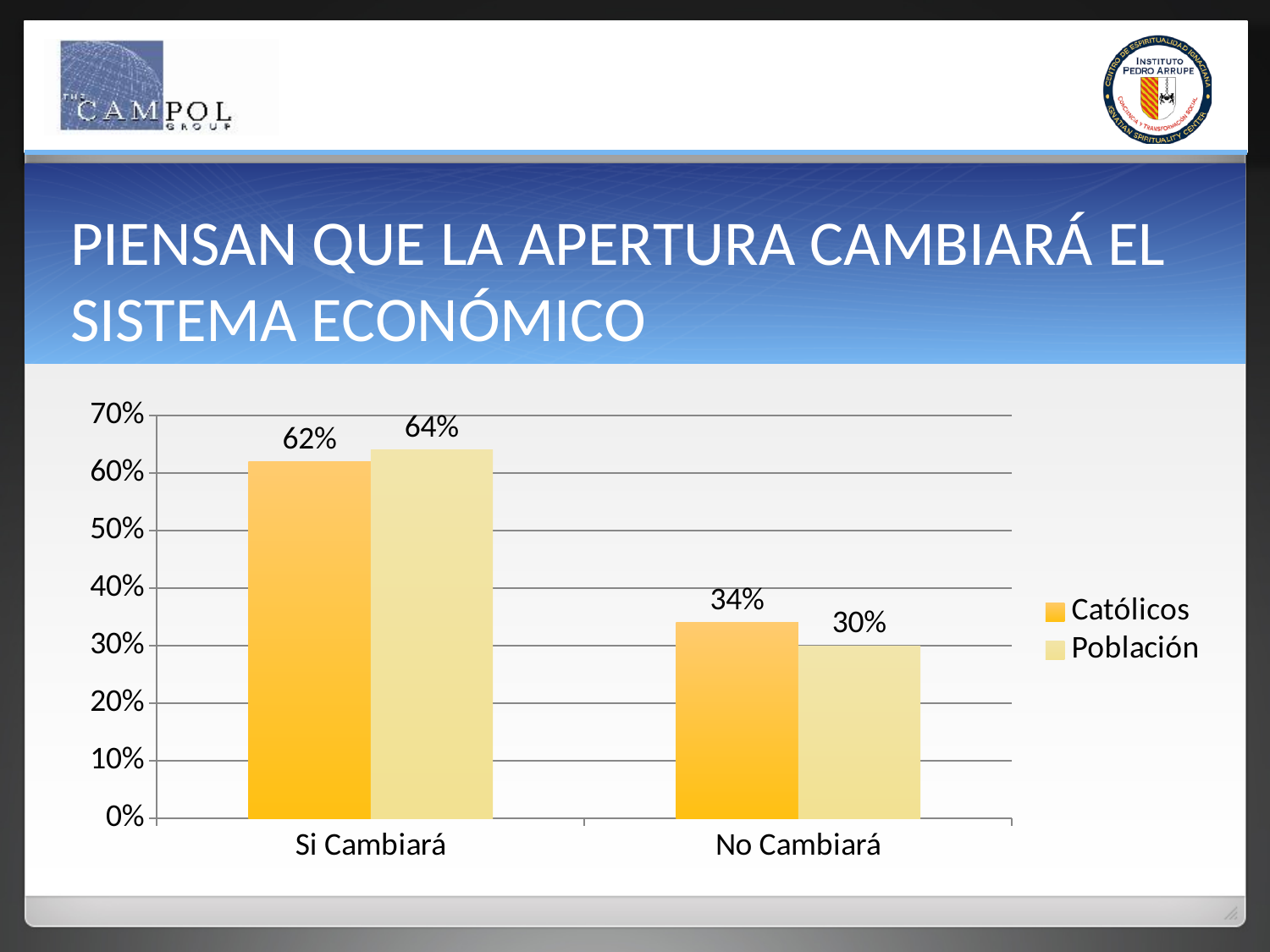
Which category has the highest value for the Población series? Si Cambiará What is the value for Población in the Si Cambiará category? 64% Which category has the lowest value for the Católicos series? No Cambiará What is the difference between the Católicos and Población values in the No Cambiará category? 4% What is the difference between the Población and Católicos values in the Si Cambiará category? 2% What is the value for Población in the No Cambiará category? 30% What kind of chart is shown on the slide? Bar chart What is the value for Católicos in the Si Cambiará category? 62% What is the value for Católicos in the No Cambiará category? 34% In the No Cambiará category, which series has the larger value, Católicos or Población? Católicos How many categories are shown on the x axis? 2 How many series does the legend list? 2